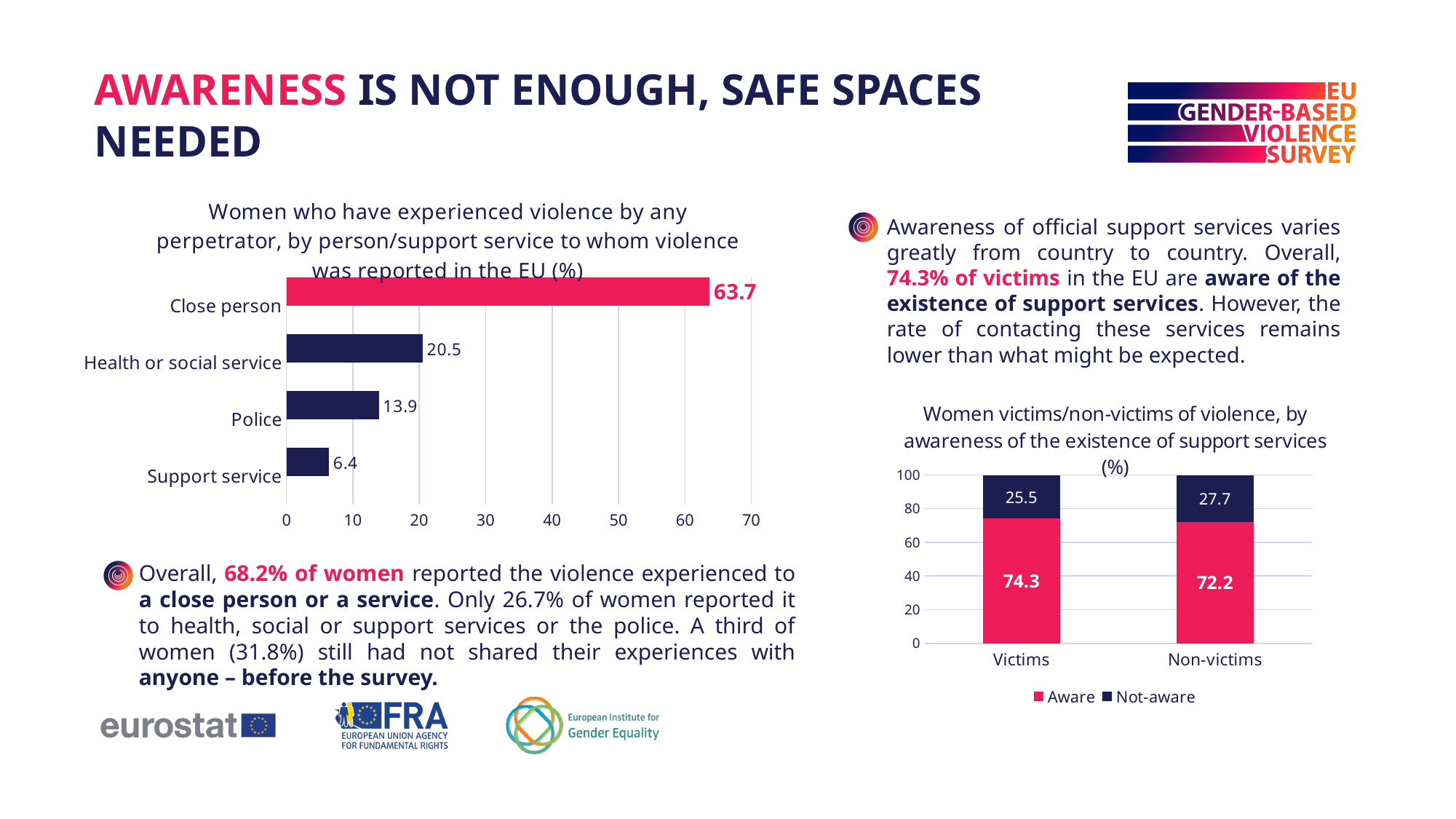
In the right chart on women victims/non-victims of violence by awareness of support services, what is the Aware value for Non-victims? 72.2 In the right chart on women victims/non-victims of violence by awareness of support services, which group has the larger Aware value, Victims or Non-victims? Victims In the left chart on women who have experienced violence by person/support service to whom violence was reported, what is the value for Close person? 63.7 In the right chart on women victims/non-victims of violence by awareness of support services, how many series does the legend list? 2 In the left chart on women who have experienced violence by person/support service to whom violence was reported, which category has the lowest value? Support service In the right chart on women victims/non-victims of violence by awareness of support services, what is the total of the stacked bar for Non-victims? 99.9 In the left chart on women who have experienced violence by person/support service to whom violence was reported, what is the difference between Health or social service and Police? 6.6 In the left chart on women who have experienced violence by person/support service to whom violence was reported, what is the value for Police? 13.9 In the right chart on women victims/non-victims of violence by awareness of support services, what is the Not-aware value for Victims? 25.5 In the left chart on women who have experienced violence by person/support service to whom violence was reported, how many categories are shown? 4 In the left chart on women who have experienced violence by person/support service to whom violence was reported, which category has the highest value? Close person What kind of chart is the left chart on women who have experienced violence by person/support service to whom violence was reported? Bar chart